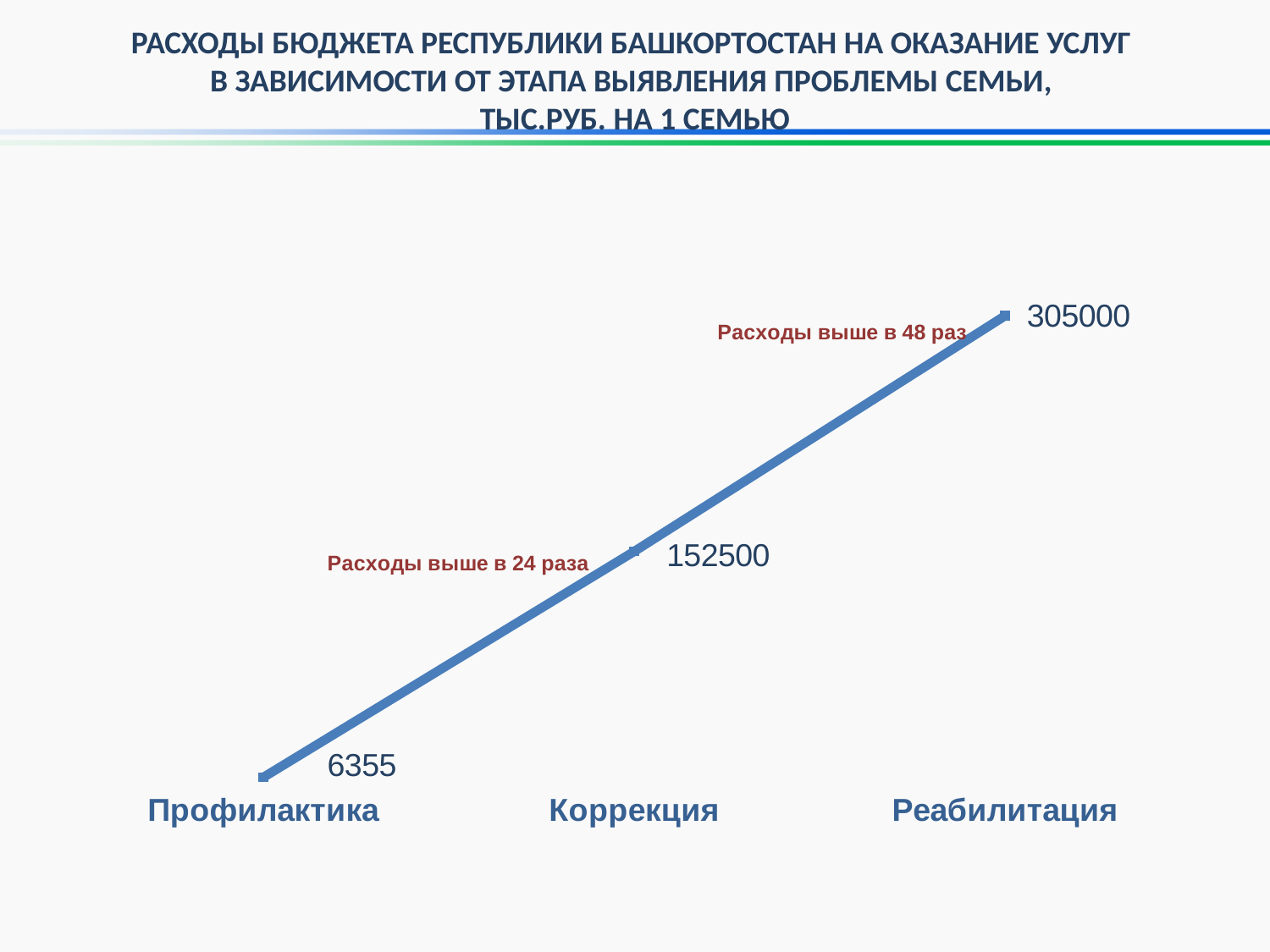
Which is larger, the value for Коррекция or the value for Профилактика? Коррекция What is the difference between the values for Коррекция and Профилактика? 146145 What is the value for Коррекция? 152500 What is the difference between the values for Реабилитация and Коррекция? 152500 How many stages are plotted on the chart? 3 What is the value for Профилактика? 6355 Which stage has the highest value? Реабилитация According to the annotation on the chart, how many times higher are the costs at Реабилитация compared with Профилактика? 48 раз Which stage has the lowest value? Профилактика What is the value for Реабилитация? 305000 What kind of chart is shown on the slide? line chart Do the values rise or fall from Профилактика to Реабилитация? rise